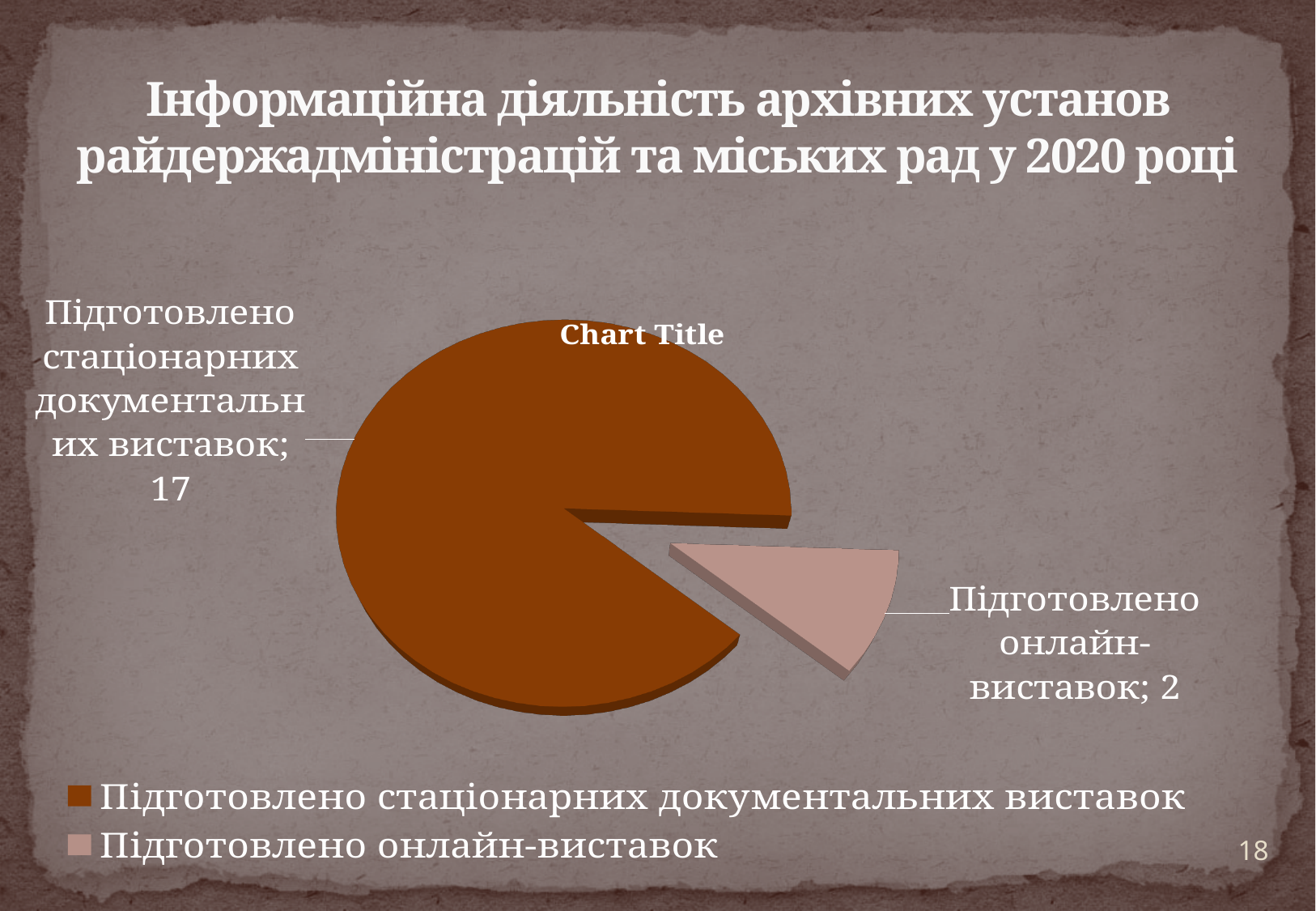
Which category has the smallest slice of the pie? Підготовлено онлайн-виставок How many slices does the pie chart have? 2 What is the value for "Підготовлено онлайн-виставок"? 2 What title is printed inside the chart area? Chart Title How many entries does the legend list? 2 What share of the total do online exhibitions represent? 2 of 19 What is the value for "Підготовлено стаціонарних документальних виставок"? 17 What is the difference between the number of stationary documentary exhibitions and online exhibitions? 15 Which category has the largest slice of the pie? Підготовлено стаціонарних документальних виставок Which is larger: the value for stationary documentary exhibitions or the value for online exhibitions? Підготовлено стаціонарних документальних виставок What is the total of the two values shown in the pie chart? 19 What type of chart is shown on the slide? Pie chart